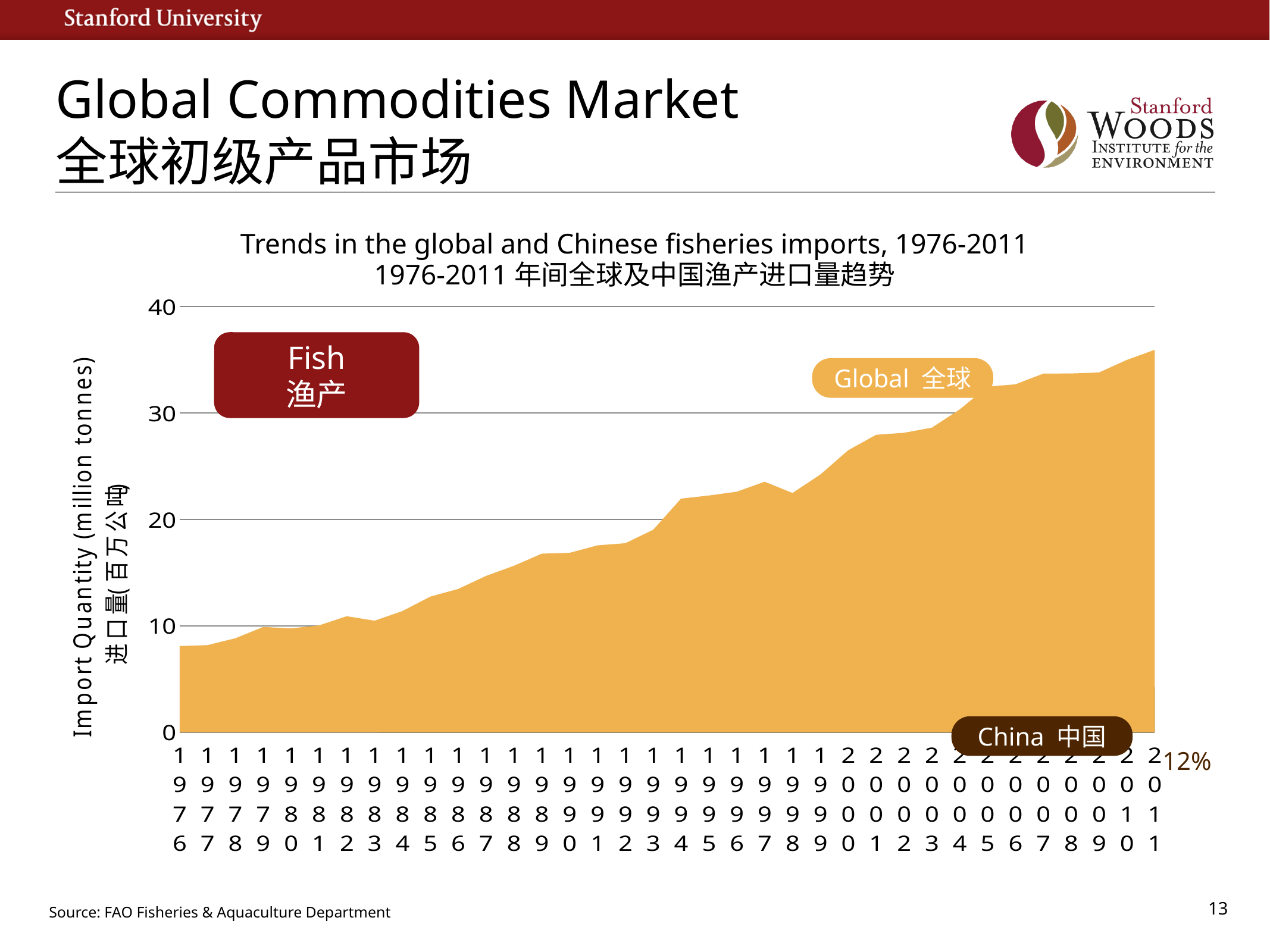
What is the label of the y-axis? Import Quantity (million tonnes) Is the global import quantity for 2011 greater or less than 30 million tonnes? greater Do global fisheries imports generally rise or fall from 1976 to 2011? Rise Is the global import quantity for 1985 greater or less than 10 million tonnes? greater Which year has the highest global fisheries import quantity? 2011 Which is larger, the global import quantity in 2000 or in 1980? 2000 Is the global import quantity for 1976 greater or less than 10 million tonnes? less How many years are plotted along the x-axis? 36 What is the title of the chart? Trends in the global and Chinese fisheries imports, 1976-2011 What kind of chart is shown on the slide? Area chart